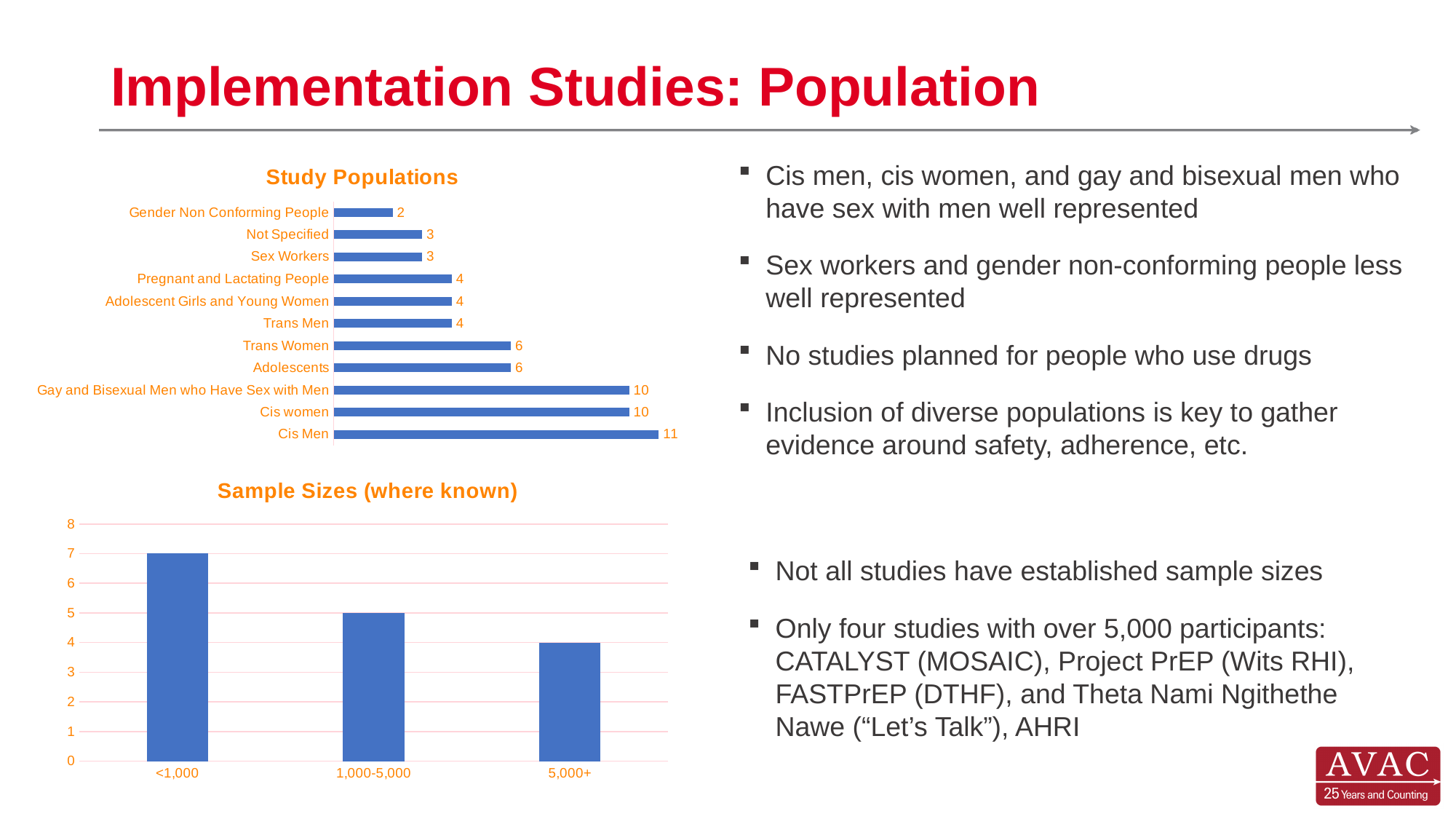
How many categories are shown in the Study Populations chart? 11 In the Sample Sizes (where known) chart, do the values rise or fall from left to right along the x axis? Fall In the Study Populations chart, which category has the lowest value? Gender Non Conforming People In the Study Populations chart, what is the value for Cis Men? 11 In the Study Populations chart, which is larger: the value for Adolescents or the value for Trans Men? Adolescents In the Study Populations chart, what is the value for Trans Women? 6 In the Study Populations chart, which category has the highest value? Cis Men In the Sample Sizes (where known) chart, what is the value for the <1,000 category? 7 In the Study Populations chart, what is the difference between the values for Cis Men and Sex Workers? 8 What kind of chart is the Study Populations chart? Bar chart How many categories are shown in the Sample Sizes (where known) chart? 3 In the Sample Sizes (where known) chart, which category has the lowest value? 5,000+